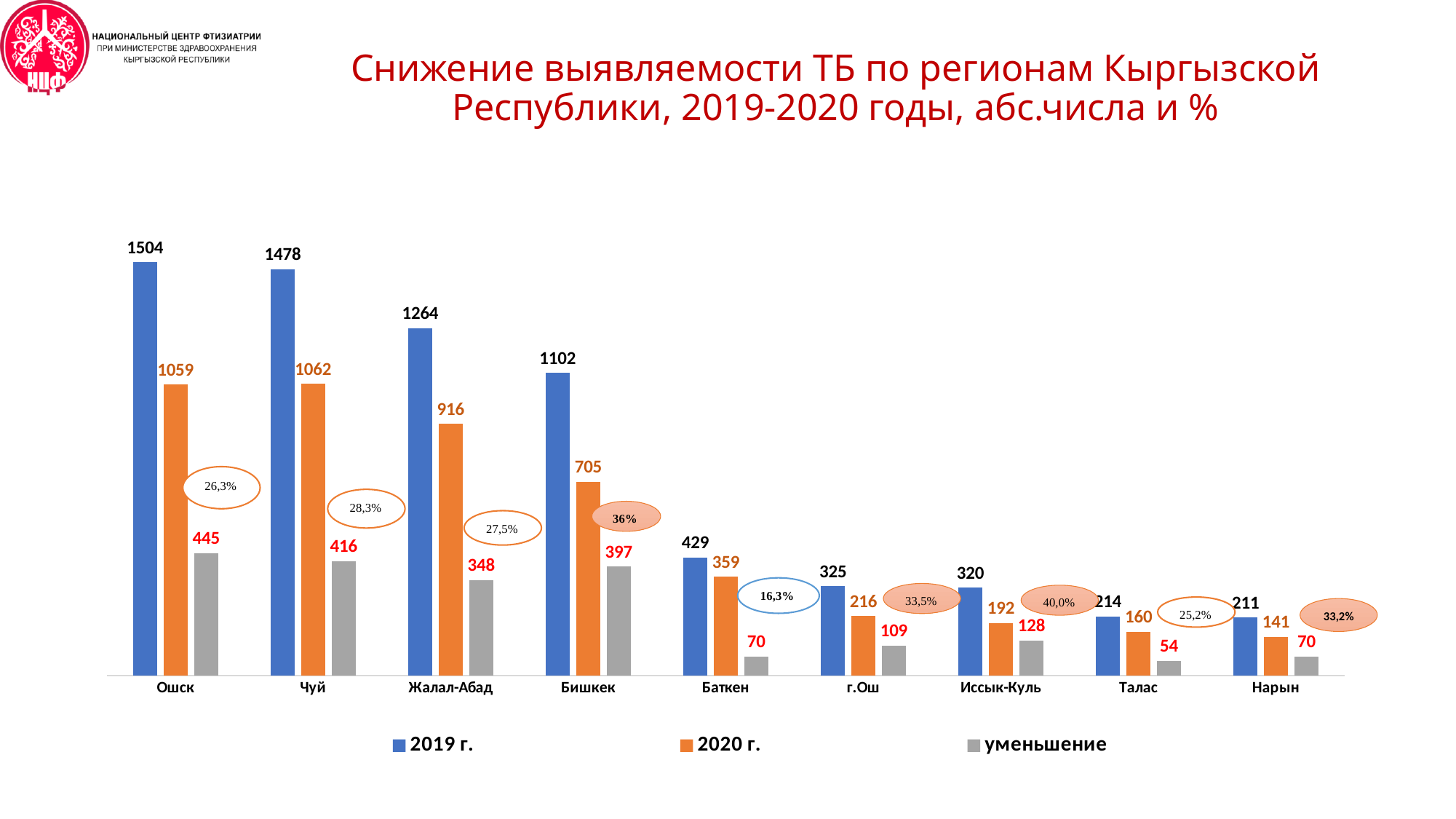
Which region has the lowest 2020 г. value? Нарын What percentage decrease is shown in the oval for Иссык-Куль? 40,0% What is the value for Жалал-Абад in the 2020 г. series? 916 Which region has the highest 2019 г. value? Ошск How many regions are shown on the x axis? 9 How many series does the legend list? 3 Do the 2019 г. values generally rise or fall from left to right along the x axis? Fall Which is larger, the 2020 г. value for Ошск or the 2020 г. value for Чуй? Чуй What is the уменьшение value for Баткен? 70 What kind of chart is shown on the slide? Bar chart What is the difference between the 2019 г. and 2020 г. values for Бишкек? 397 What is the value for Чуй in the 2019 г. series? 1478